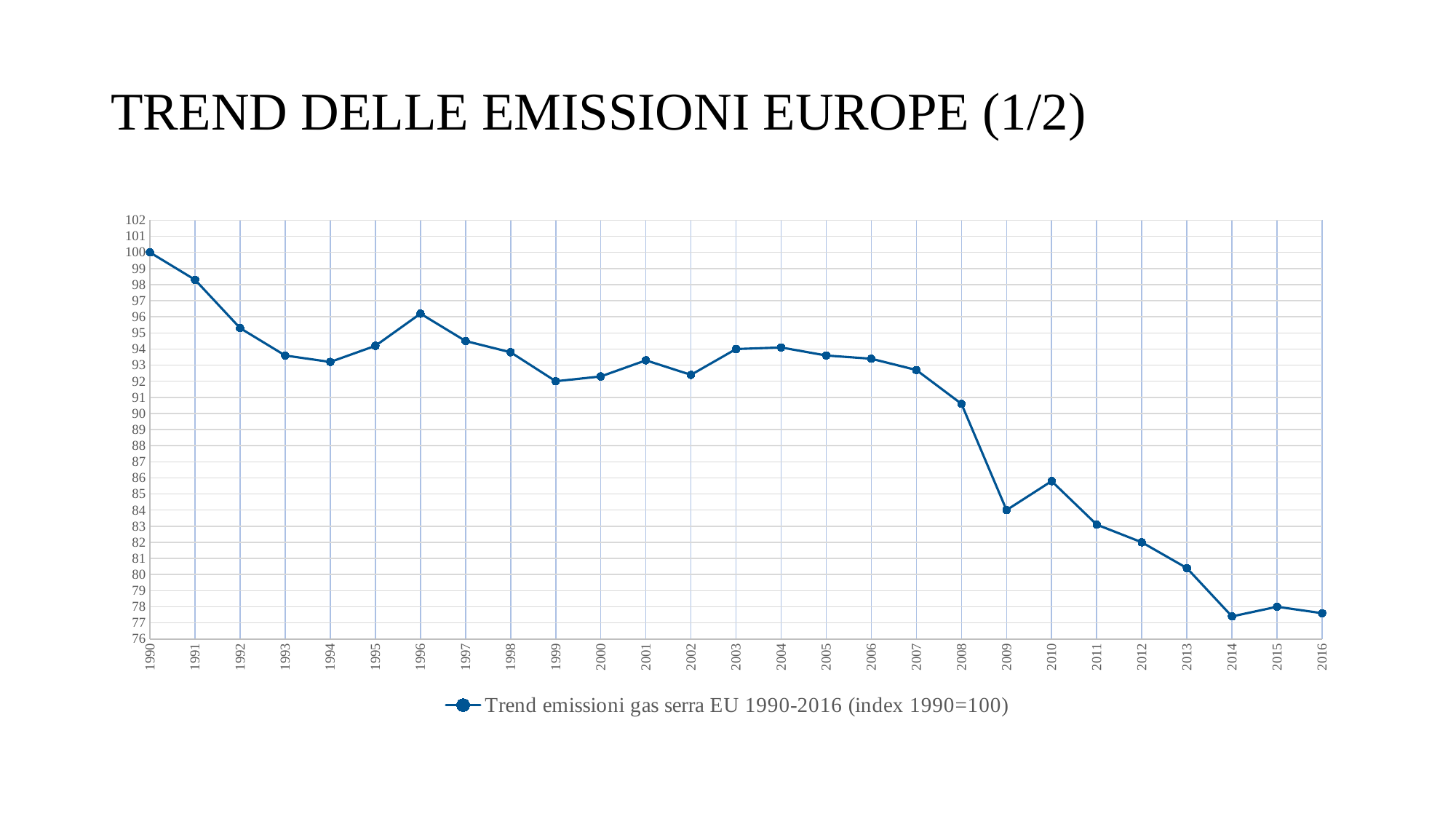
How many series does the legend list? 1 Is the value for 2016 greater or less than 80? less Is the value for 2008 greater or less than 90? greater Which year has the larger value, 1996 or 1997? 1996 Which year has the larger value, 2009 or 2010? 2010 What kind of chart is shown on the slide? Line chart Which year has the highest value on the chart? 1990 What is the value of the emissions index for 1990? 100 Is the value for 2009 greater or less than 85? less How many years are plotted on the x axis? 27 Overall, do the values rise or fall from 1990 to 2016? Fall